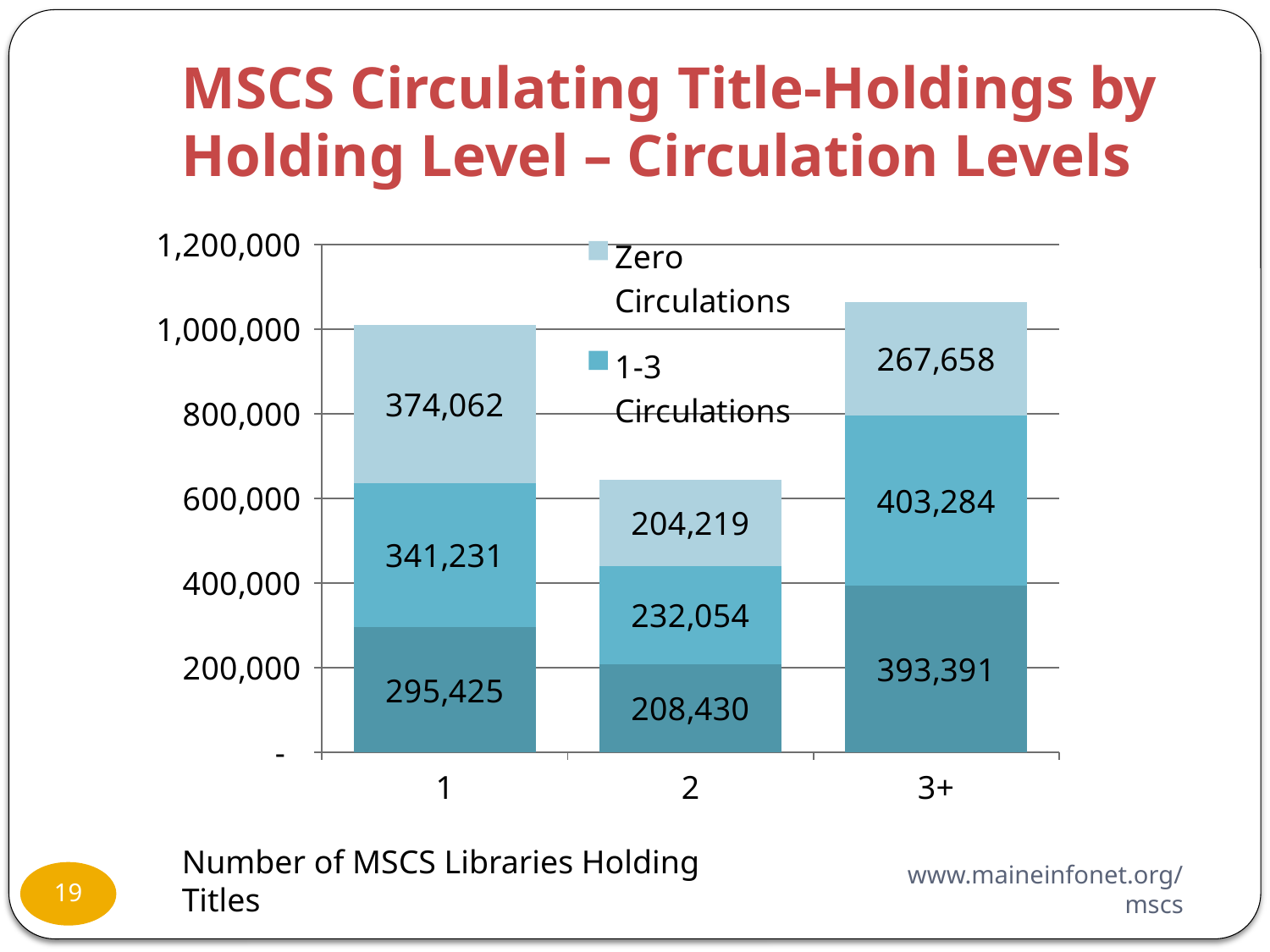
Which holding level has the lowest 1-3 Circulations value? 2 How many holding-level categories are shown on the x axis? 3 Is the total height of the bar for holding level 3+ greater or less than 1,000,000? greater Which holding level has the highest Zero Circulations value? 1 What kind of chart is shown on the slide? Stacked bar chart What is the difference between the 1-3 Circulations values for holding level 3+ and holding level 1? 62,053 What is the value of the Zero Circulations segment for holding level 2? 204,219 What is the value of the 1-3 Circulations segment for holding level 3+? 403,284 Which has the larger Zero Circulations value, holding level 1 or holding level 3+? 1 What is the total of the stacked bar for holding level 2? 644,703 What is the value of the bottom (darkest) segment of the bar for holding level 3+? 393,391 What is the value of the Zero Circulations segment for holding level 1? 374,062